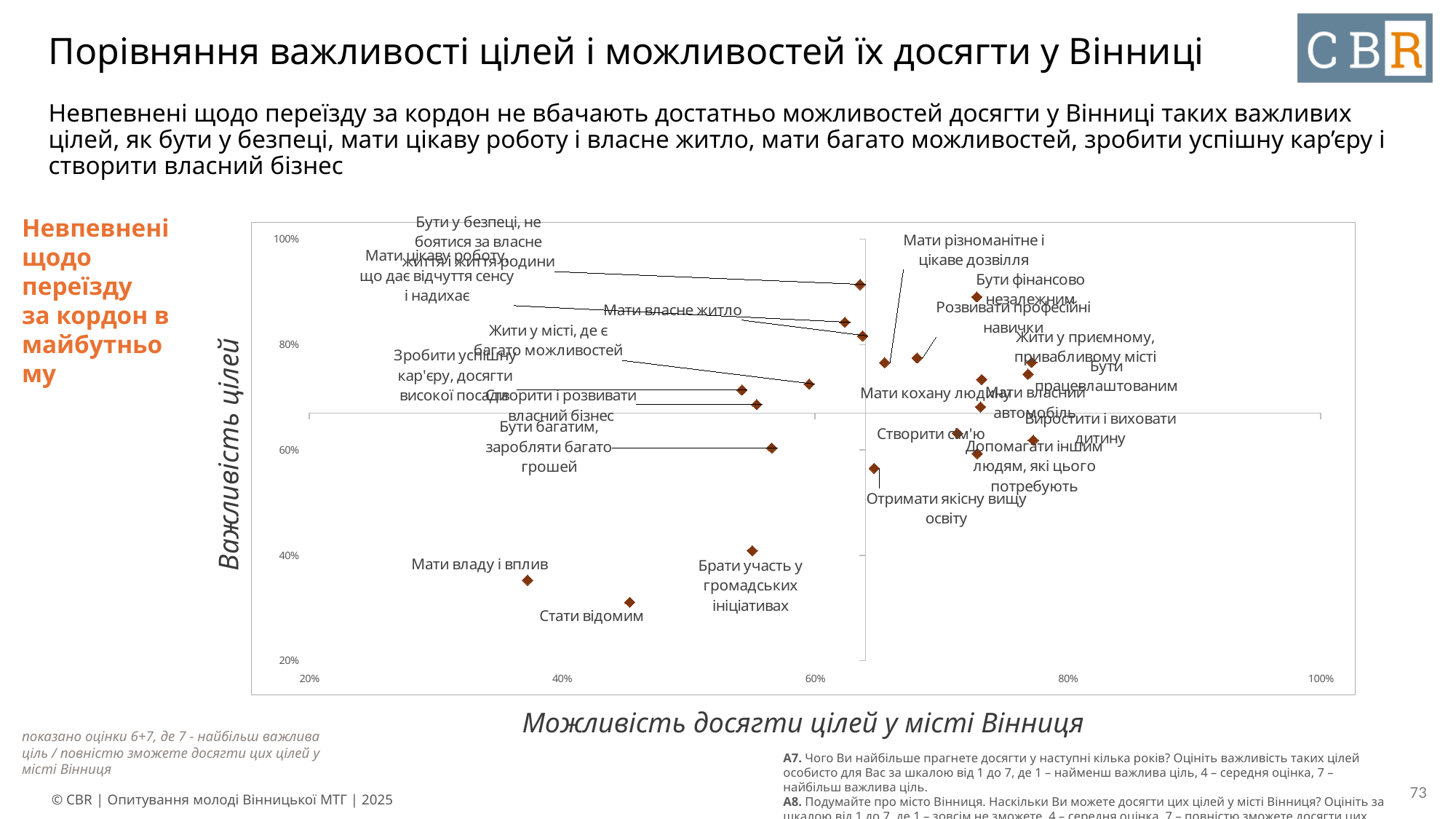
Is the horizontal-axis value for 'Стати відомим' greater or less than 60%? less Is the importance value for 'Бути у безпеці, не боятися за власне життя і життя родини' greater or less than 80%? greater Which goal has higher importance: 'Бути у безпеці, не боятися за власне життя і життя родини' or 'Стати відомим'? Бути у безпеці, не боятися за власне життя і життя родини Is the importance value for 'Брати участь у громадських ініціативах' greater or less than 60%? less What is the title of the horizontal axis of the chart? Можливість досягти цілей у місті Вінниця What is the title of the vertical axis of the chart? Важливість цілей What kind of chart is shown on the slide? scatter chart Which goal has the lowest value on the horizontal axis (possibility to achieve in Vinnytsia)? Мати владу і вплив Which goal has a higher value on the horizontal axis: 'Мати владу і вплив' or 'Бути фінансово незалежним'? Бути фінансово незалежним Which goal has the lowest importance (vertical axis) in the chart? Стати відомим